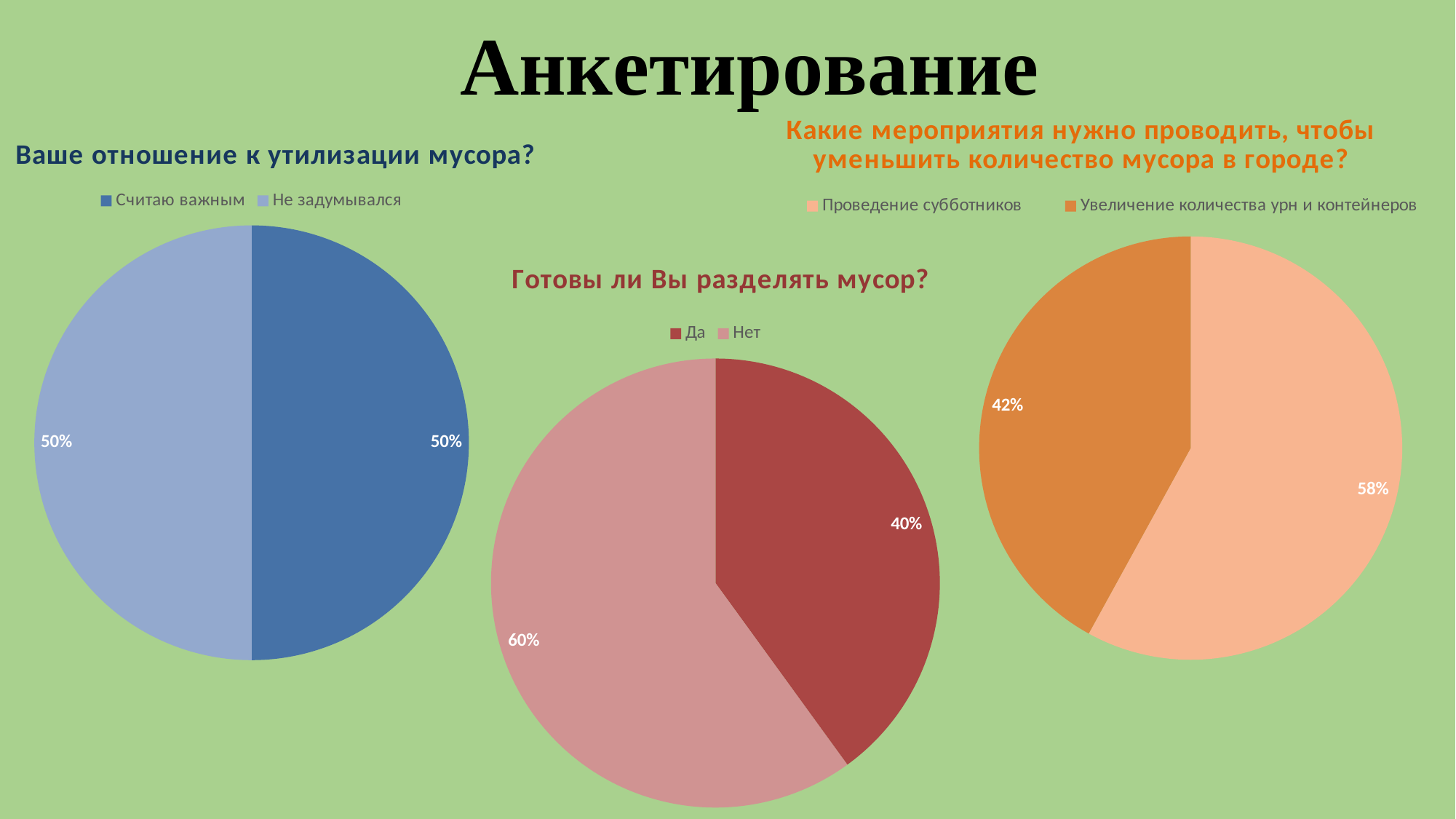
What type of chart is used for "Ваше отношение к утилизации мусора?"? Pie chart In the chart titled "Готовы ли Вы разделять мусор?", which answer has the largest share? Нет In the chart titled "Готовы ли Вы разделять мусор?", what share of respondents answered "Нет"? 60% How many categories does the legend of the chart titled "Готовы ли Вы разделять мусор?" list? 2 In the chart titled "Какие мероприятия нужно проводить, чтобы уменьшить количество мусора в городе?", which option has the smallest share? Увеличение количества урн и контейнеров In the chart titled "Готовы ли Вы разделять мусор?", what is the difference in percentage points between "Нет" and "Да"? 20 percentage points In the chart titled "Ваше отношение к утилизации мусора?", what is the value for "Считаю важным"? 50% In the chart titled "Какие мероприятия нужно проводить, чтобы уменьшить количество мусора в городе?", which is larger: "Проведение субботников" or "Увеличение количества урн и контейнеров"? Проведение субботников In the chart titled "Готовы ли Вы разделять мусор?", what share of respondents answered "Да"? 40% In the chart titled "Какие мероприятия нужно проводить, чтобы уменьшить количество мусора в городе?", what is the value for "Увеличение количества урн и контейнеров"? 42% In the chart titled "Какие мероприятия нужно проводить, чтобы уменьшить количество мусора в городе?", what is the value for "Проведение субботников"? 58% How many pie charts are shown on the slide? 3